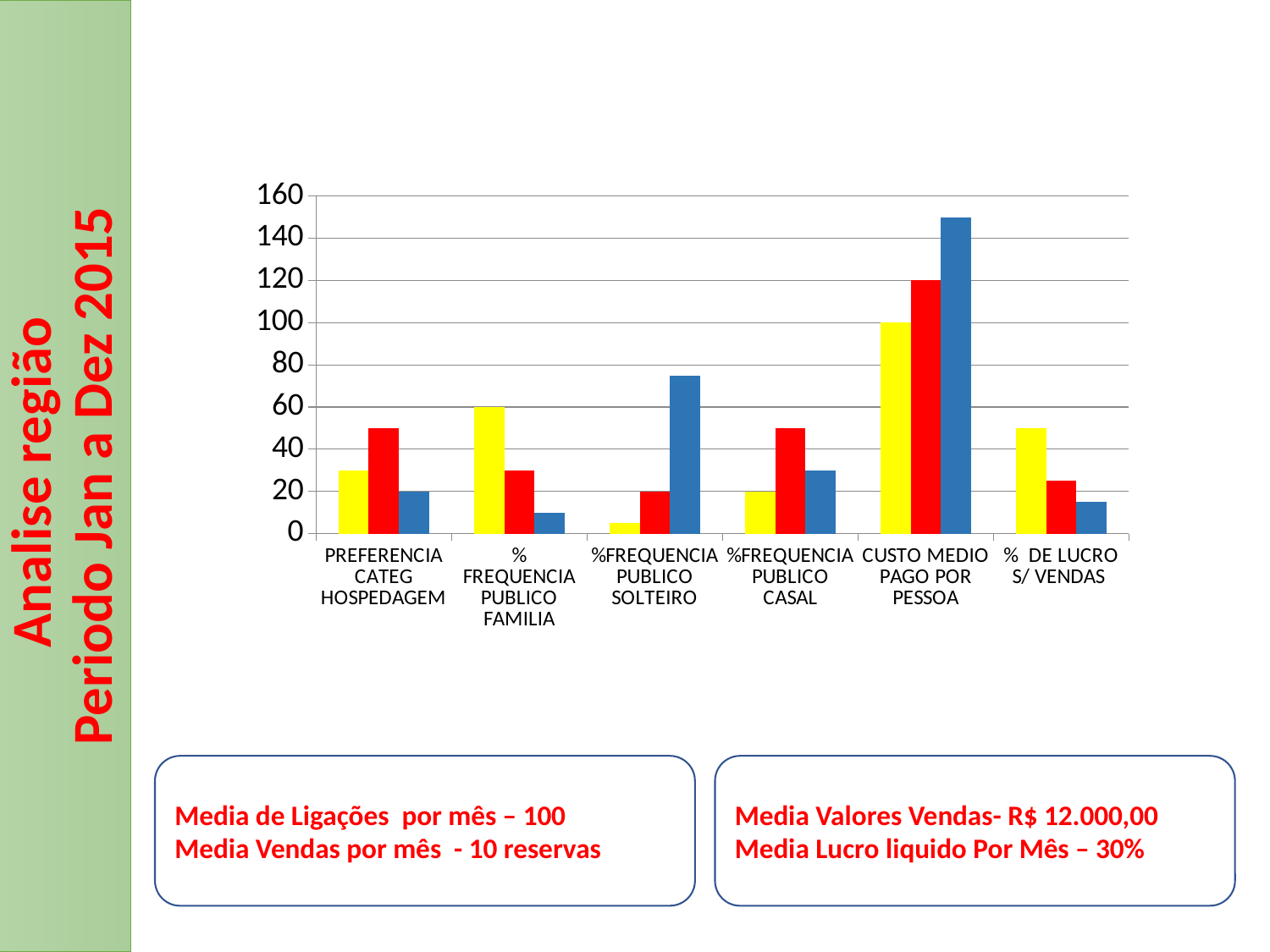
Is the value of the blue bar for %FREQUENCIA PUBLICO SOLTEIRO greater or less than 60? greater What is the value of the blue bar for PREFERENCIA CATEG HOSPEDAGEM? 20 How many categories are shown on the x axis of the chart? 6 Is the value of the blue bar for CUSTO MEDIO PAGO POR PESSOA greater or less than 140? greater What is the value of the yellow bar for % FREQUENCIA PUBLICO FAMILIA? 60 What is the value of the yellow bar for CUSTO MEDIO PAGO POR PESSOA? 100 What is the value of the red bar for CUSTO MEDIO PAGO POR PESSOA? 120 Is the value of the yellow bar for %FREQUENCIA PUBLICO SOLTEIRO greater or less than 20? less What is the difference between the red bar and the yellow bar for CUSTO MEDIO PAGO POR PESSOA? 20 What kind of chart is shown on the slide? bar chart Which category has the tallest bar in the chart? CUSTO MEDIO PAGO POR PESSOA Which is larger for %FREQUENCIA PUBLICO CASAL: the red bar or the blue bar? the red bar